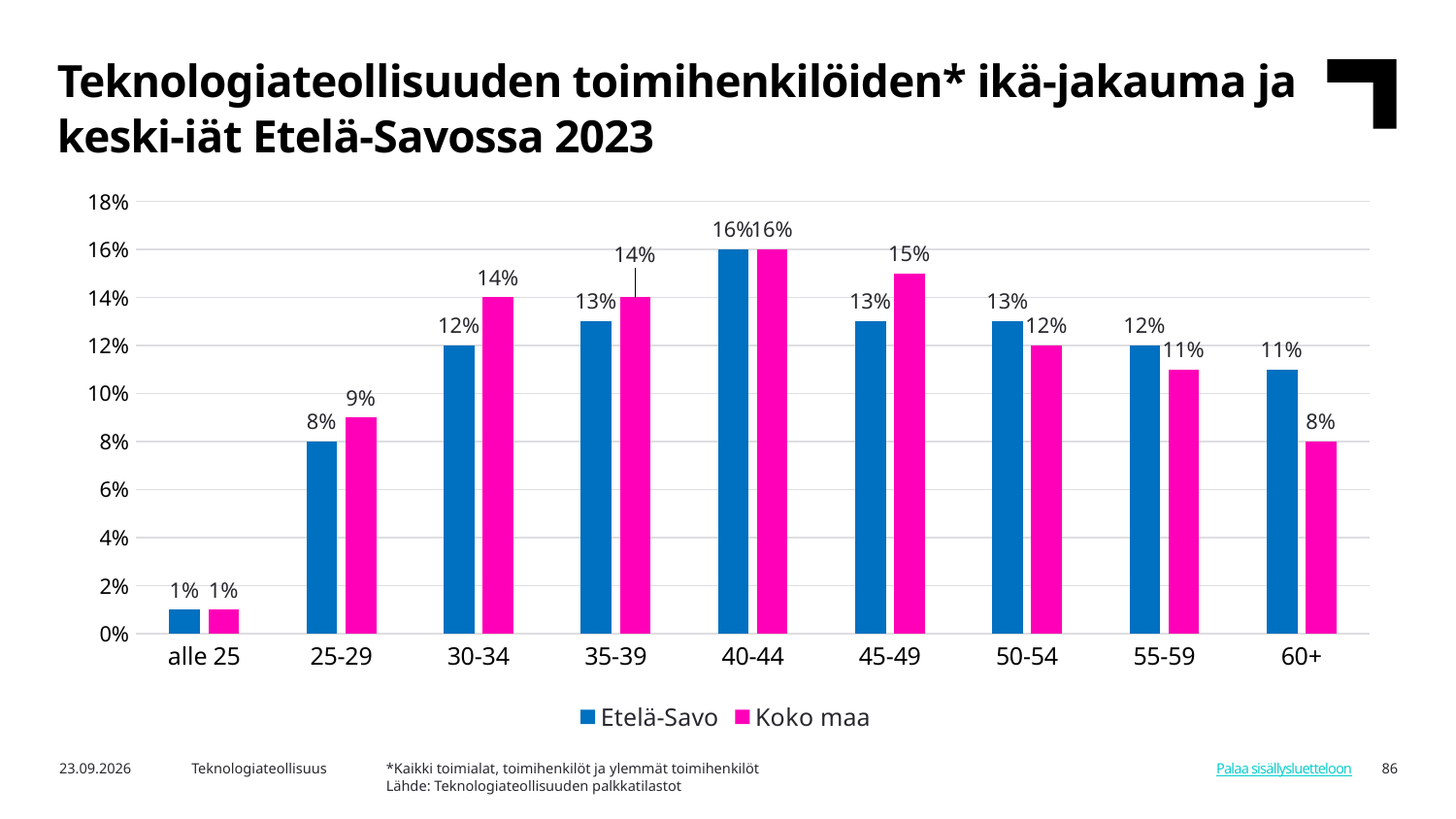
What is the value for Koko maa in the 60+ age group? 8% Which age group has the highest value for Etelä-Savo? 40-44 What is the difference between the Koko maa and Etelä-Savo values in the 60+ age group? 3% What is the value for Etelä-Savo in the 30-34 age group? 12% What is the value for Koko maa in the 45-49 age group? 15% What kind of chart is shown on the slide? Bar chart How many age groups are shown on the x axis? 9 Which series is shown in pink in the legend? Koko maa What is the difference between the Koko maa and Etelä-Savo values in the 30-34 age group? 2% In the 50-54 age group, which series has the larger value, Etelä-Savo or Koko maa? Etelä-Savo How many series does the legend list? 2 Which age group has the lowest value for Koko maa? alle 25